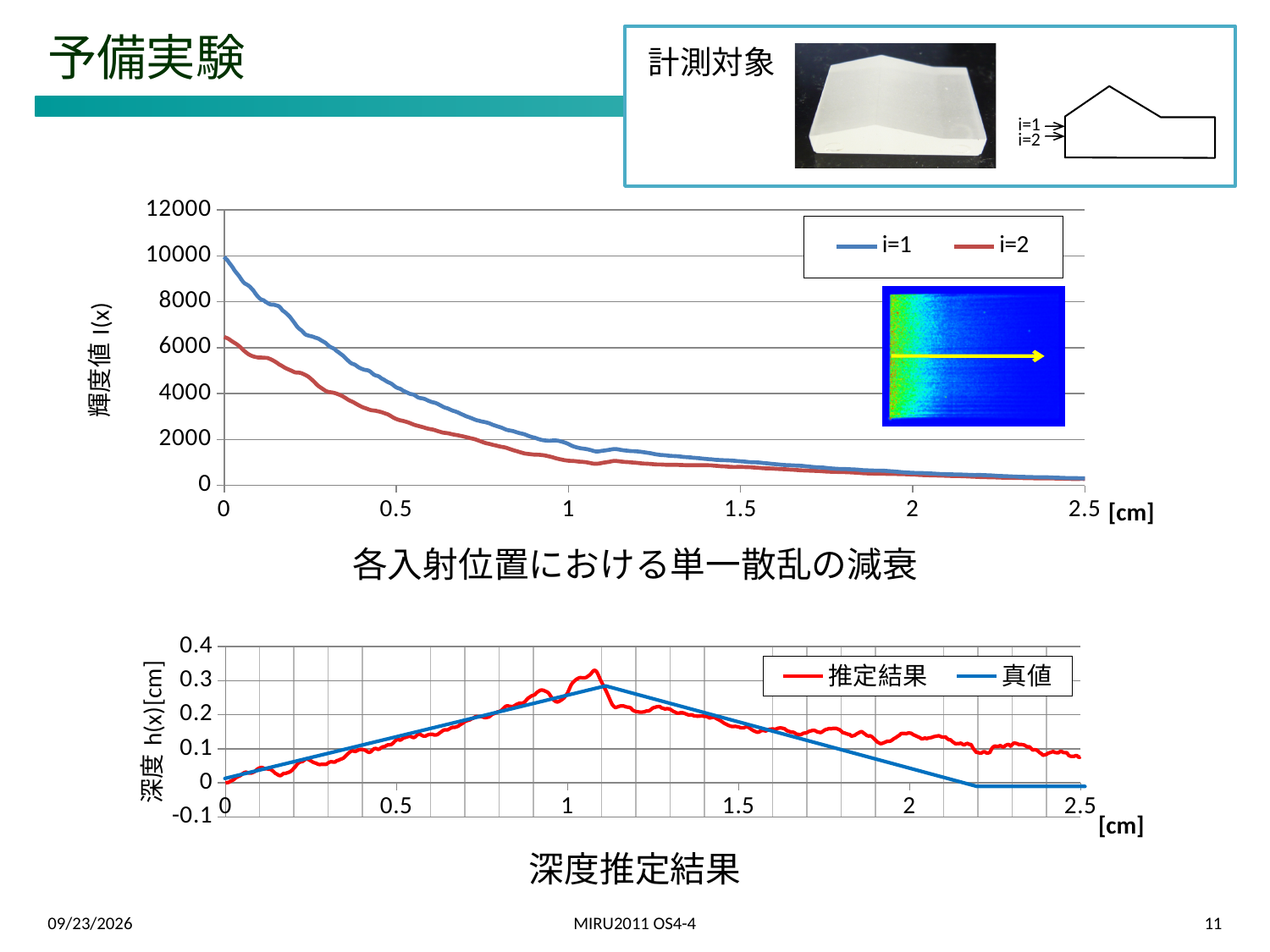
In the top chart (各入射位置における単一散乱の減衰), what kind of chart is shown? line chart In the bottom chart (深度推定結果), how many series does the legend list? 2 In the top chart (各入射位置における単一散乱の減衰), is the value of i=1 at x=0 greater or less than 8000? greater In the top chart (各入射位置における単一散乱の減衰), is the value of i=2 at x=0 greater or less than 8000? less In the bottom chart (深度推定結果), what are the two legend entries? 推定結果, 真値 In the top chart (各入射位置における単一散乱の減衰), which series has the larger value at x=0.5, i=1 or i=2? i=1 In the top chart (各入射位置における単一散乱の減衰), what unit is shown on the x axis? [cm] In the bottom chart (深度推定結果), is the value of 推定結果 at x=1 greater or less than 0.2? greater In the top chart (各入射位置における単一散乱の減衰), do the values of i=1 rise or fall as x increases? fall In the bottom chart (深度推定結果), which series has the larger value at x=2, 推定結果 or 真値? 推定結果 In the top chart (各入射位置における単一散乱の減衰), how many series does the legend list? 2